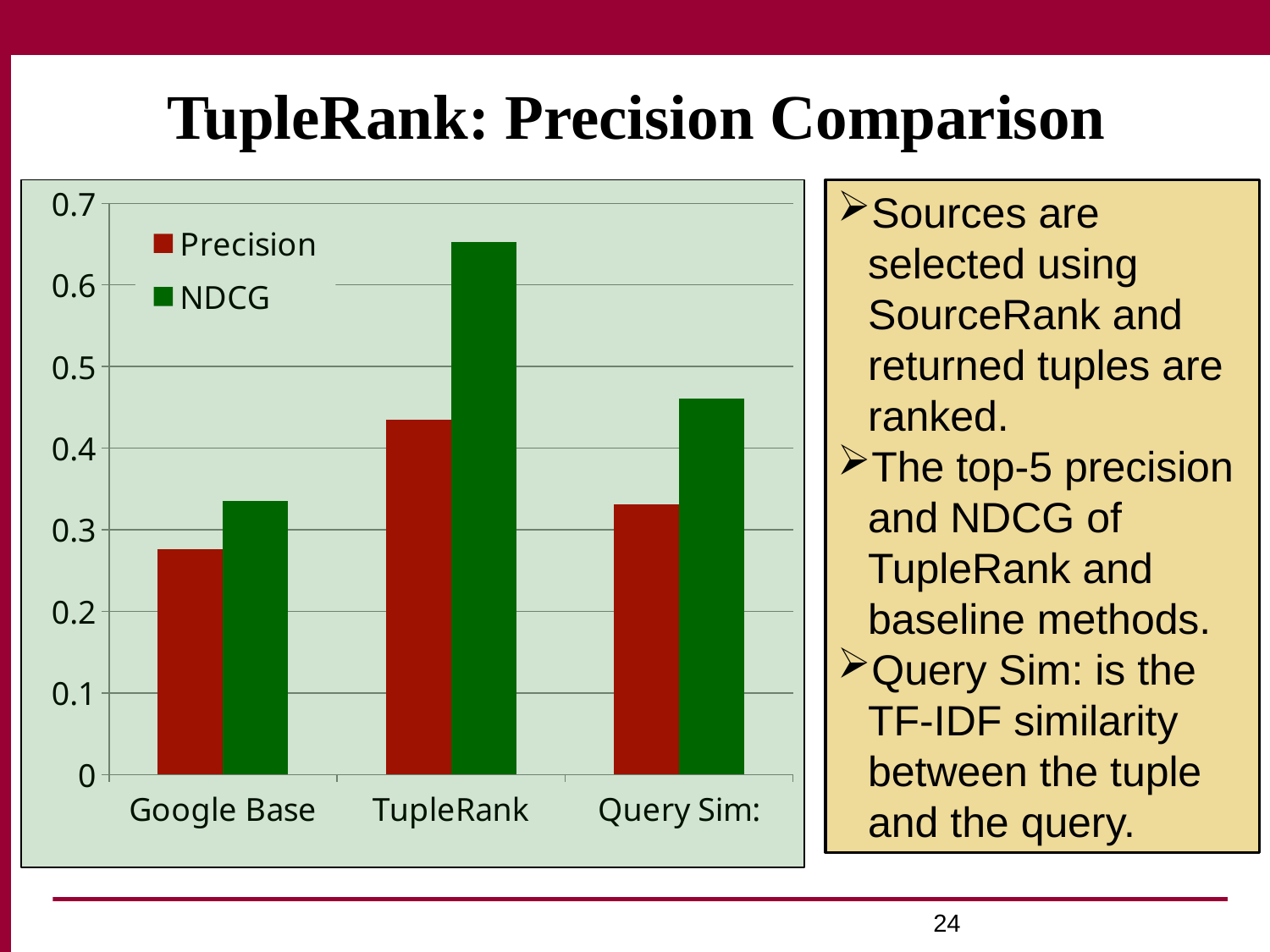
Which is larger for TupleRank, the Precision value or the NDCG value? NDCG Which category has the lowest NDCG value? Google Base How many categories are shown on the x axis? 3 Which category has the lowest Precision value? Google Base What kind of chart is shown on the slide? bar chart What colour are the NDCG bars in the chart? green Is the NDCG value for TupleRank greater or less than 0.6? greater Which category has the highest Precision value? TupleRank Is the Precision value for Google Base greater or less than 0.3? less Which category has the highest NDCG value? TupleRank How many series does the legend list? 2 Is the NDCG value for Query Sim: greater or less than 0.5? less